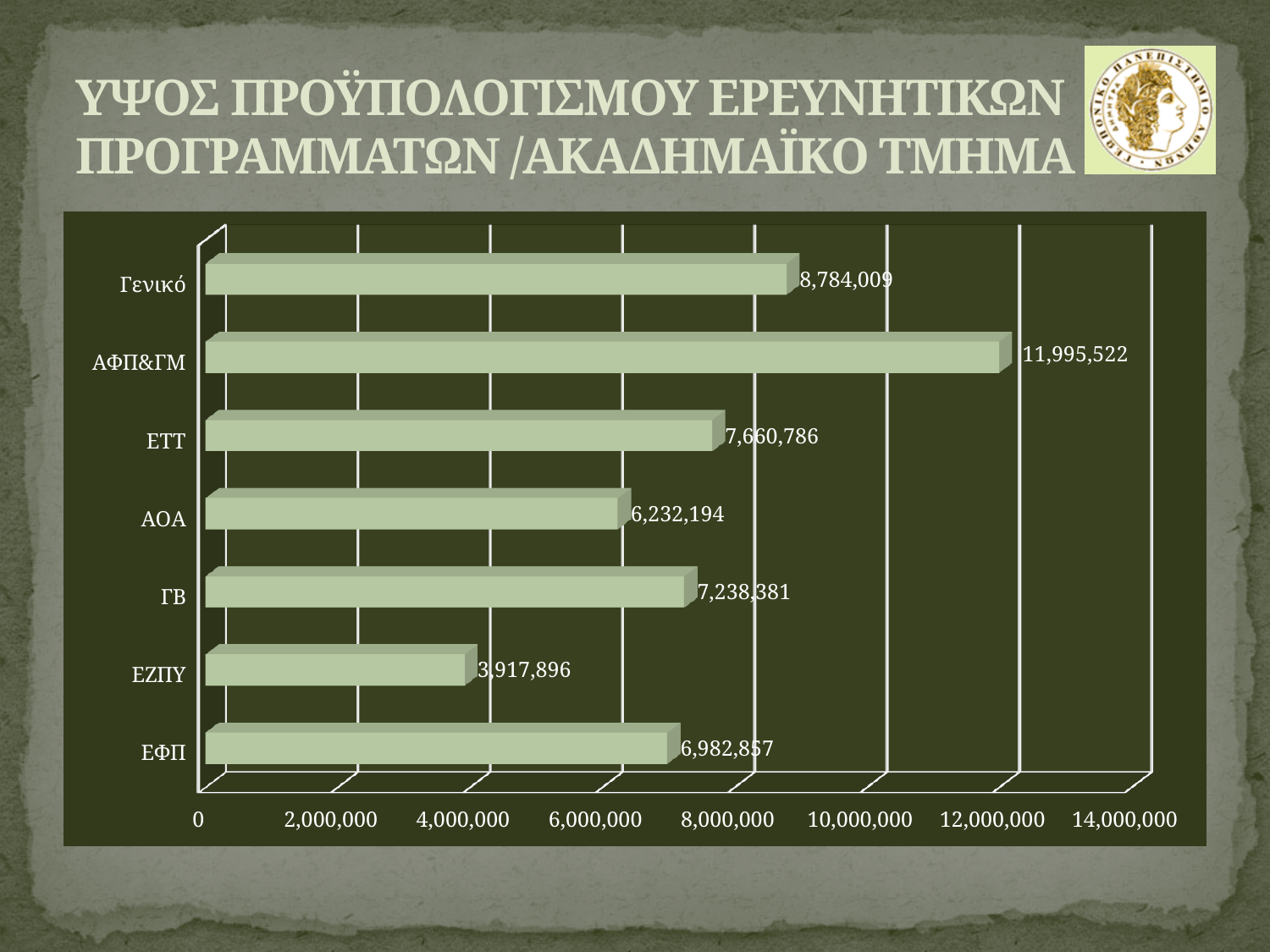
Which category has the lowest value? ΕΖΠΥ What is the value for Γενικό? 8,784,009 Is the value for ΓΒ greater or less than 6,000,000? greater What is the value for ΑΦΠ&ΓΜ? 11,995,522 How many categories are shown in the chart? 7 What is the value for ΕΖΠΥ? 3,917,896 What is the value for ΑΟΑ? 6,232,194 What is the difference between the values for ΕΤΤ and ΓΒ? 422,405 Which is larger, the value for ΕΦΠ or the value for ΑΟΑ? ΕΦΠ Which category has the highest value? ΑΦΠ&ΓΜ What is the difference between the values for ΑΦΠ&ΓΜ and Γενικό? 3,211,513 What kind of chart is shown on the slide? bar chart